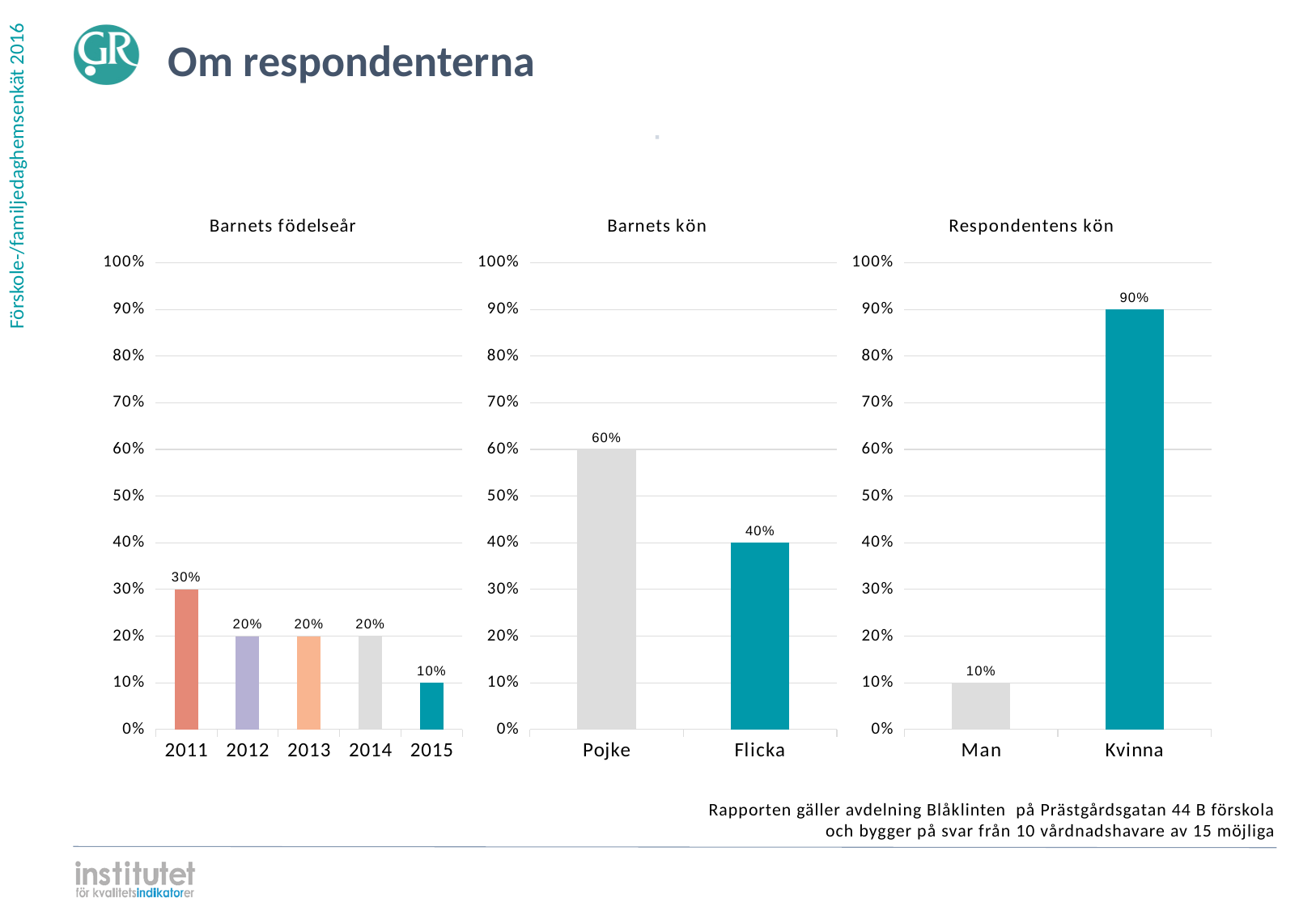
In the 'Respondentens kön' chart, what is the value for Kvinna? 90% In the 'Barnets födelseår' chart, what is the value for 2011? 30% In the 'Barnets kön' chart, what is the difference between Pojke and Flicka? 20% In the 'Barnets födelseår' chart, which year has the highest value? 2011 In the 'Barnets födelseår' chart, what is the difference between the values for 2011 and 2015? 20% In the 'Barnets födelseår' chart, which year has the lowest value? 2015 In the 'Respondentens kön' chart, what is the value for Man? 10% In the 'Barnets kön' chart, what is the value for Pojke? 60% In the 'Barnets födelseår' chart, how many years are shown on the x axis? 5 In the 'Respondentens kön' chart, what is the difference between Kvinna and Man? 80% In the 'Barnets kön' chart, which is larger, Pojke or Flicka? Pojke What kind of chart is the 'Respondentens kön' chart? Bar chart